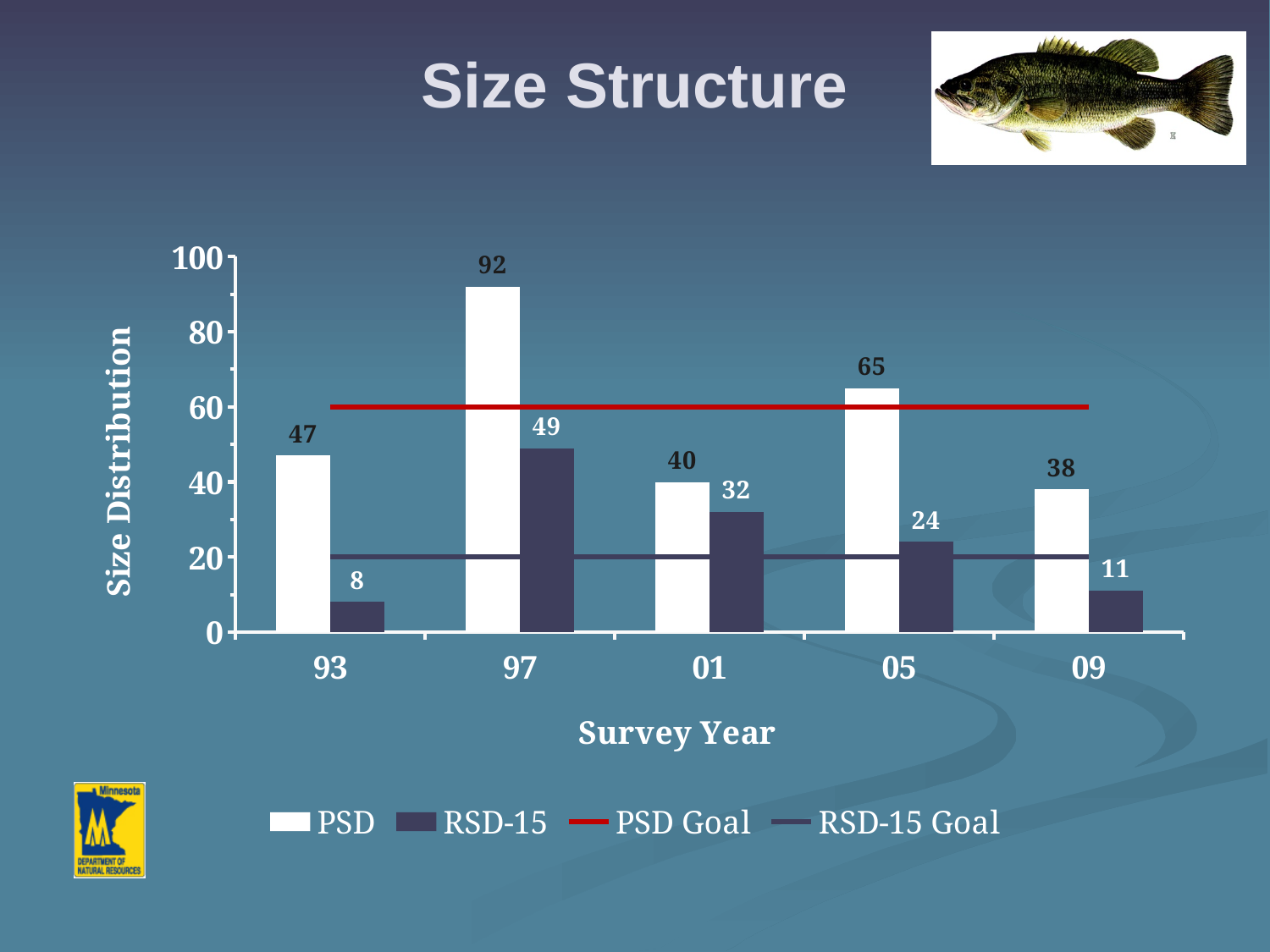
What is the difference between the PSD value and the RSD-15 value in survey year 01? 8 Which survey year has the lowest RSD-15 value? 93 How many survey years are shown on the x axis? 5 What is the label of the y axis? Size Distribution Is the PSD Goal line greater or less than 40? greater Which is larger, the RSD-15 value for 97 or the RSD-15 value for 09? 97 What kind of chart is shown on the slide? combination bar and line chart How many entries does the legend list? 4 What is the PSD value for survey year 09? 38 Which survey year has the highest PSD value? 97 What is the PSD value for survey year 97? 92 What is the RSD-15 value for survey year 05? 24